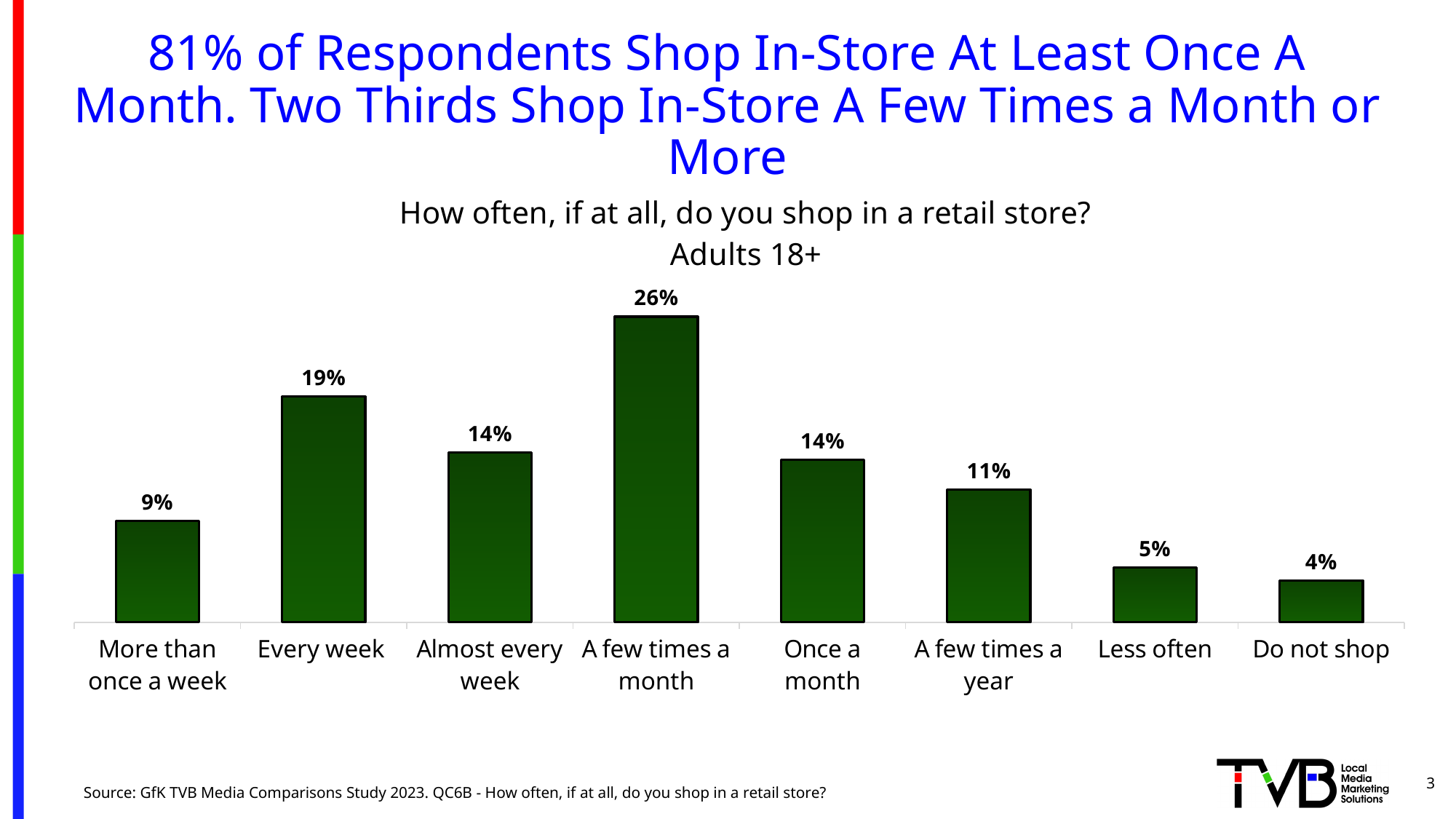
How many shopping frequency categories are shown in the chart? 8 What percentage of respondents do not shop in a retail store? 4% What type of chart is used on this slide? Bar chart Which shopping frequency category has the highest percentage of respondents? A few times a month What is the difference in percentage points between 'A few times a month' and 'Every week'? 7 What is the chart's subtitle describing the audience? Adults 18+ What percentage of respondents shop in a retail store more than once a week? 9% What percentage of respondents shop in a retail store every week? 19% Which is larger: the percentage for 'Every week' or for 'Once a month'? Every week What is the difference in percentage points between 'A few times a year' and 'Less often'? 6 What percentage of respondents shop in a retail store a few times a month? 26% Which shopping frequency category has the lowest percentage of respondents? Do not shop